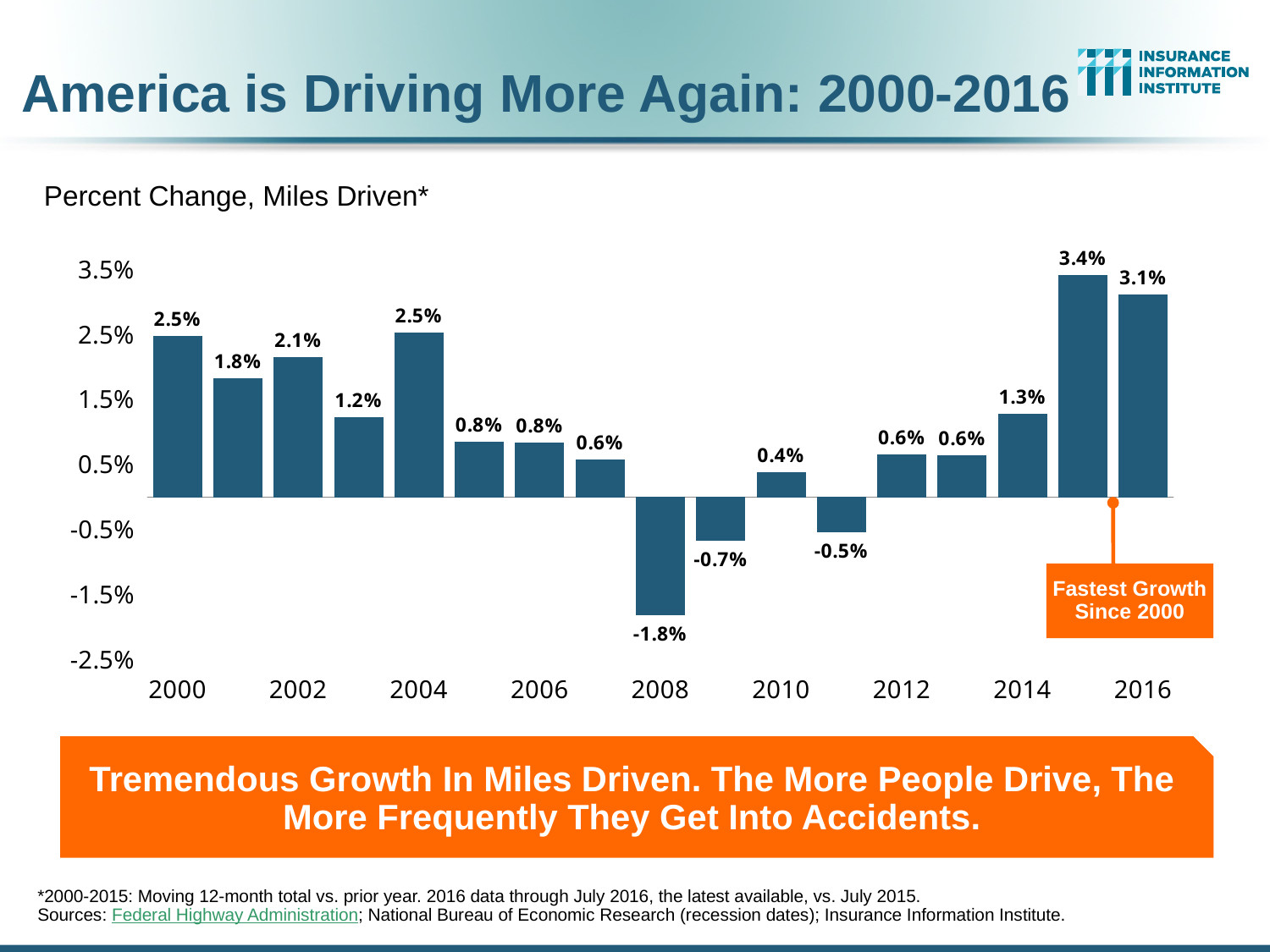
Which year has a larger percent change in miles driven, 2000 or 2002? 2000 Do the values rise or fall from 2012 to 2015? Rise Which year has the highest percent change in miles driven? 2015 What is the difference between the percent change in 2016 and the percent change in 2014? 1.8% What is the percent change in miles driven for 2008? -1.8% Which year has the lowest percent change in miles driven? 2008 What is the percent change in miles driven for 2014? 1.3% What kind of chart is shown on the slide? Bar chart What is the percent change in miles driven for 2016? 3.1% How many bars are plotted in the chart? 17 What is the percent change in miles driven for 2010? 0.4% What does the orange callout on the chart say about the 2015 bar? Fastest Growth Since 2000